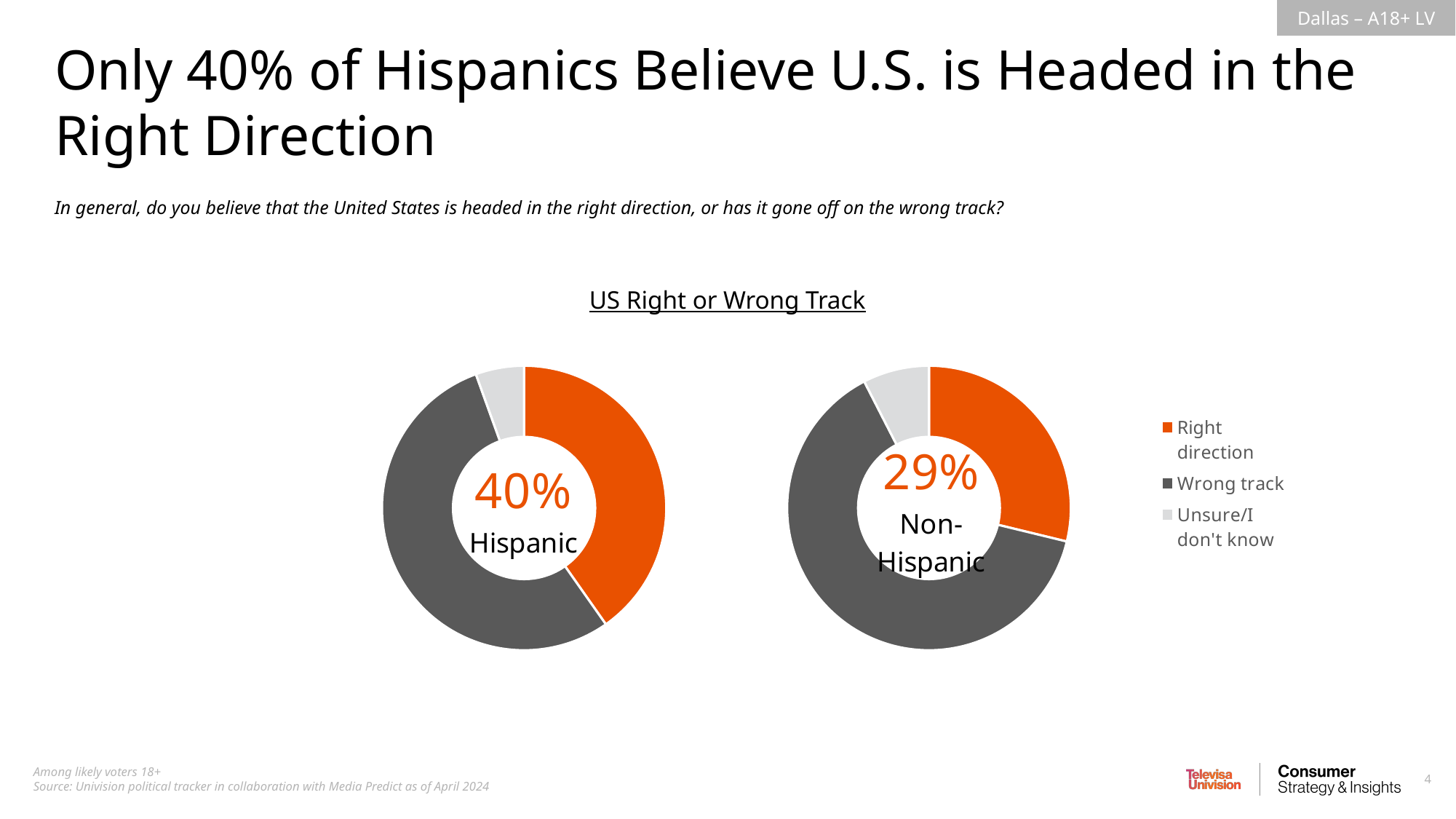
What kind of chart is used to show the US Right or Wrong Track results? Pie chart (donut) In the Non-Hispanic chart, what percentage chose Right direction? 29% How many entries does the legend list? 3 What is the title shown above the two pie charts? US Right or Wrong Track What is the difference between the Hispanic and Non-Hispanic Right direction percentages? 11 percentage points In the Hispanic chart, which response is the largest slice? Wrong track In the Non-Hispanic chart, which response is the largest slice? Wrong track What colour represents Right direction in the charts? Orange How many pie charts are shown on the slide? 2 In the Hispanic chart, what percentage chose Right direction? 40% In the Non-Hispanic chart, which response is the smallest slice? Unsure/I don't know Which group has the larger Right direction share, Hispanic or Non-Hispanic? Hispanic